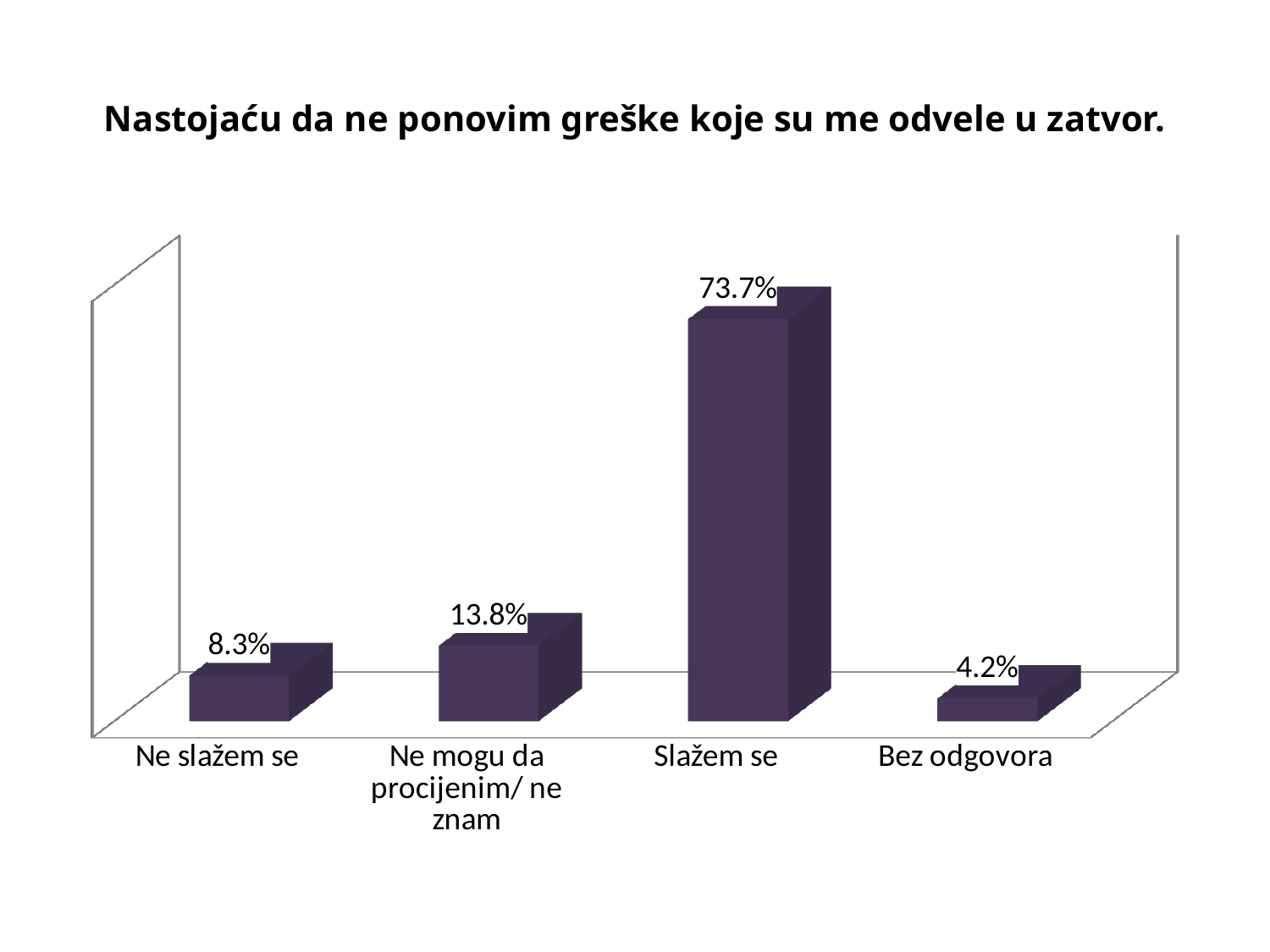
What is the title of the chart? Nastojaću da ne ponovim greške koje su me odvele u zatvor. What is the value for "Ne slažem se"? 8.3% What is the difference between the values for "Slažem se" and "Ne mogu da procijenim/ ne znam"? 59.9% Which is larger, the value for "Ne slažem se" or the value for "Ne mogu da procijenim/ ne znam"? Ne mogu da procijenim/ ne znam How many categories are shown on the chart? 4 What is the value for "Bez odgovora"? 4.2% What is the value for "Slažem se"? 73.7% What kind of chart is shown on the slide? Bar chart What is the value for "Ne mogu da procijenim/ ne znam"? 13.8% What is the difference between the values for "Ne slažem se" and "Bez odgovora"? 4.1% Which category has the highest value? Slažem se Which category has the lowest value? Bez odgovora